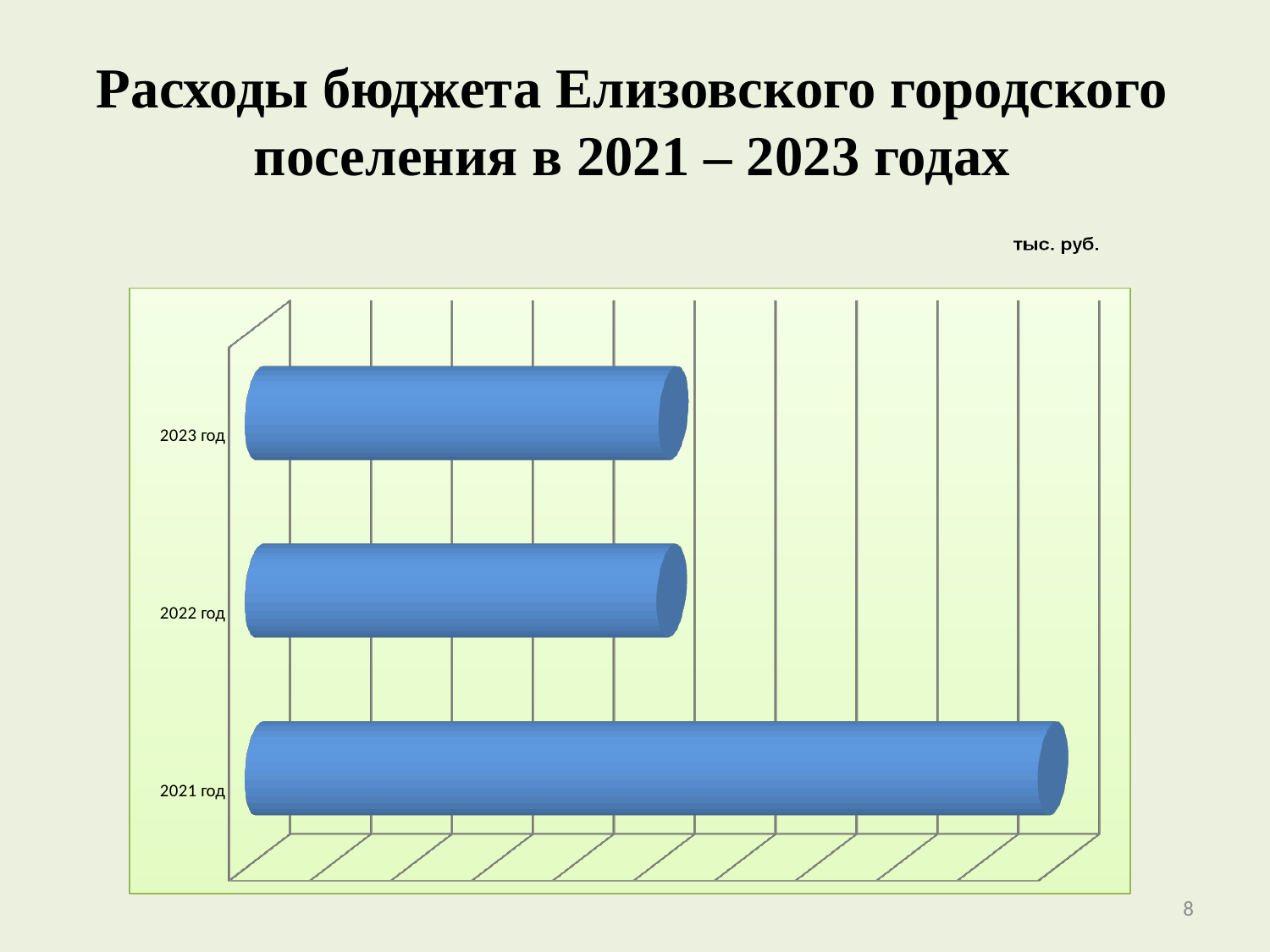
Do the expenditures rise or fall from 2021 год to 2022 год? fall In what units are the values of the chart expressed, according to the label above the chart? тыс. руб. What is the title of the chart on the slide? Расходы бюджета Елизовского городского поселения в 2021 – 2023 годах Which is larger, the value for 2021 год or the value for 2023 год? 2021 год Which category is listed at the bottom of the chart's vertical axis? 2021 год Which year has the highest budget expenditure in the chart? 2021 год What kind of chart is shown on the slide? bar chart Which is larger, the value for 2021 год or the value for 2022 год? 2021 год How many categories (years) are plotted in the chart? 3